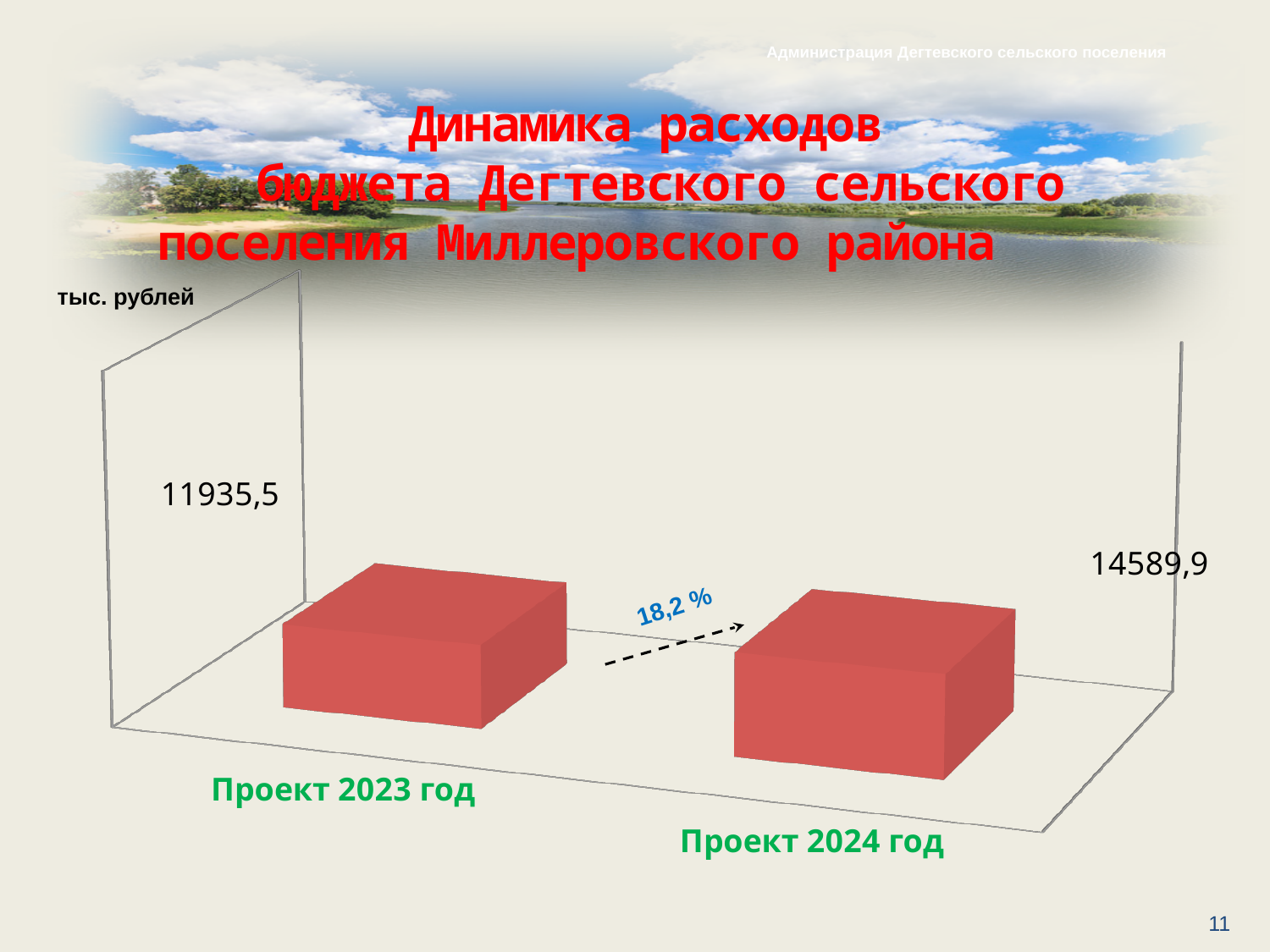
Which is larger, the value for Проект 2023 год or Проект 2024 год? Проект 2024 год What percentage change is shown on the arrow between the two bars? 18,2 % How many categories are shown in the chart? 2 What unit of measurement is indicated on the chart? тыс. рублей Which category has the highest value? Проект 2024 год What is the value for Проект 2024 год? 14589,9 Which category has the lowest value? Проект 2023 год What kind of chart is shown on the slide? bar chart What is the value for Проект 2023 год? 11935,5 Do the values rise or fall from Проект 2023 год to Проект 2024 год? rise What is the difference between the values for Проект 2024 год and Проект 2023 год? 2654,4